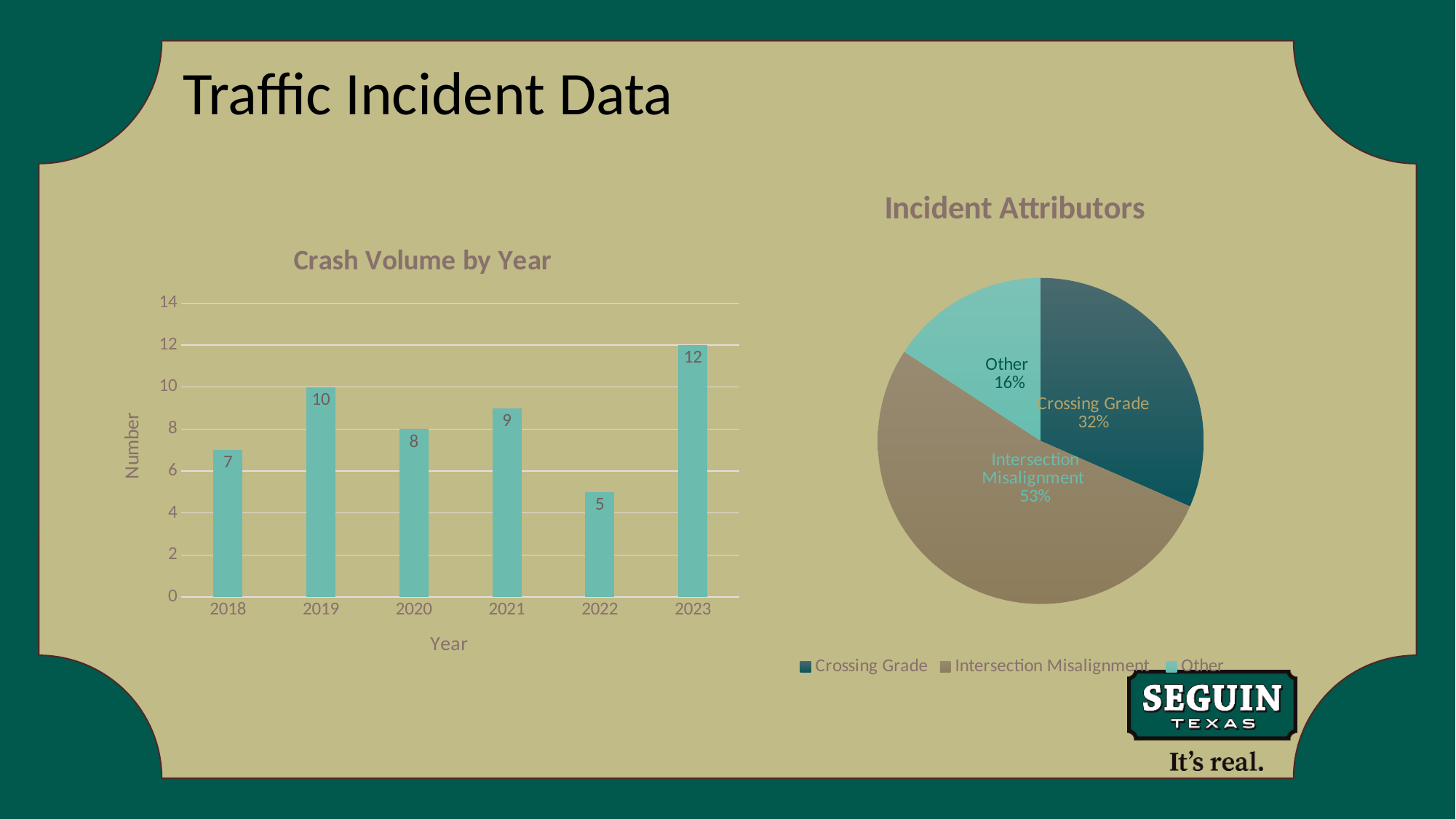
In the 'Crash Volume by Year' chart, what is the value for 2022? 5 In the 'Crash Volume by Year' chart, which year has the highest crash volume? 2023 In the 'Crash Volume by Year' chart, what is the value for 2019? 10 What kind of chart is 'Incident Attributors'? Pie chart In the 'Crash Volume by Year' chart, how many years are shown on the x axis? 6 In the 'Crash Volume by Year' chart, which year has the lowest crash volume? 2022 In the 'Crash Volume by Year' chart, which is larger, the value for 2020 or the value for 2021? 2021 How many entries does the legend of the 'Incident Attributors' chart list? 3 In the 'Incident Attributors' chart, which category has the smallest share? Other In the 'Crash Volume by Year' chart, what is the difference between the values for 2023 and 2018? 5 What kind of chart is 'Crash Volume by Year'? Bar chart In the 'Incident Attributors' chart, what share does Intersection Misalignment have? 53%